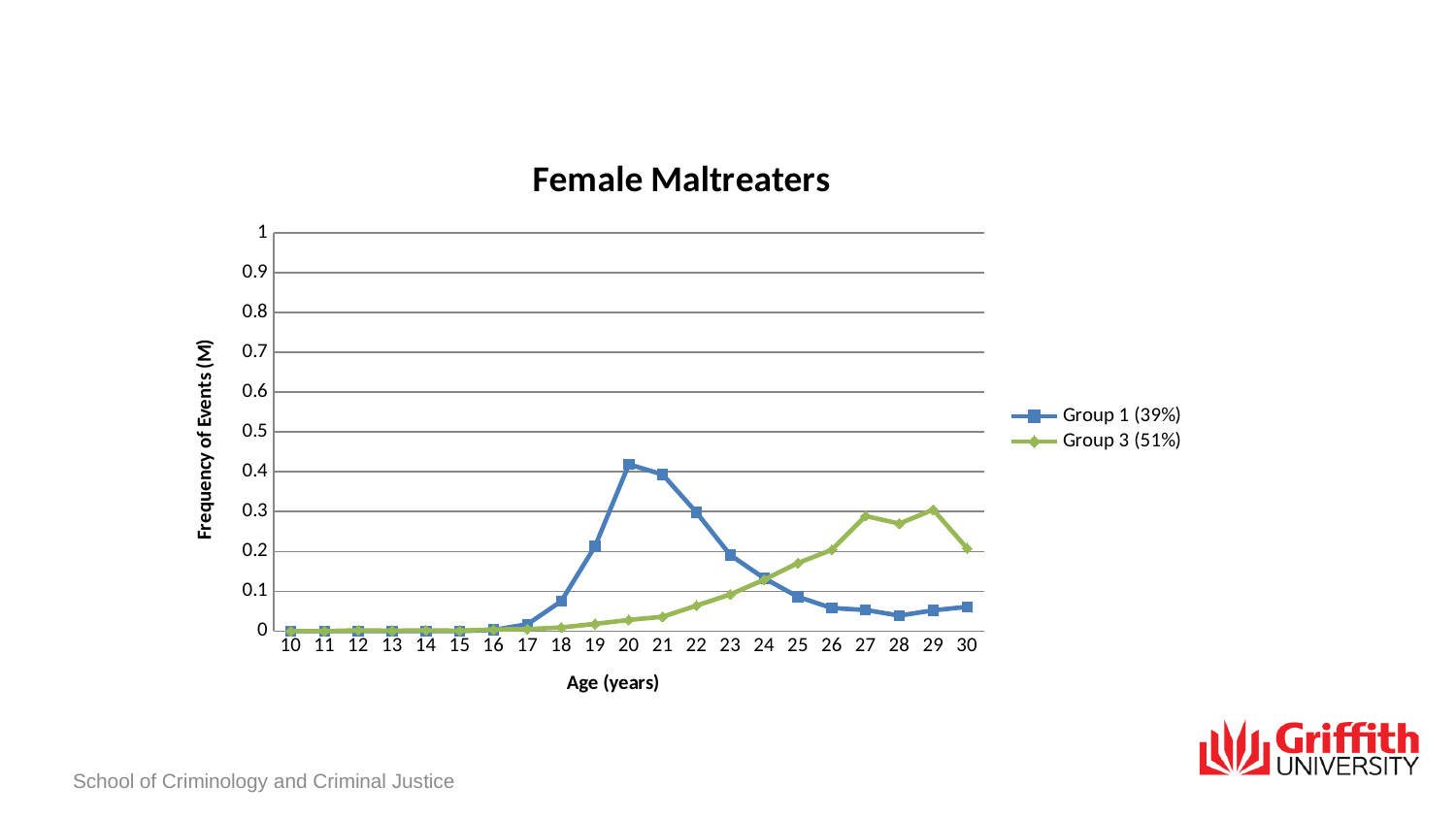
At which age does Group 3 (51%) reach its highest frequency? 29 How many series does the legend list? 2 At which age does Group 1 (39%) reach its highest frequency? 20 What is the label of the y axis? Frequency of Events (M) Is the value for Group 1 (39%) at age 20 greater or less than 0.4? greater Does the Group 1 (39%) line rise or fall between age 20 and age 28? Fall Is the value for Group 1 (39%) at age 25 greater or less than 0.1? less At age 20, which series has the higher value, Group 1 (39%) or Group 3 (51%)? Group 1 (39%) How many age points are plotted along the x axis? 21 What type of chart is shown on the slide? Line chart At age 28, which series has the higher value, Group 1 (39%) or Group 3 (51%)? Group 3 (51%)